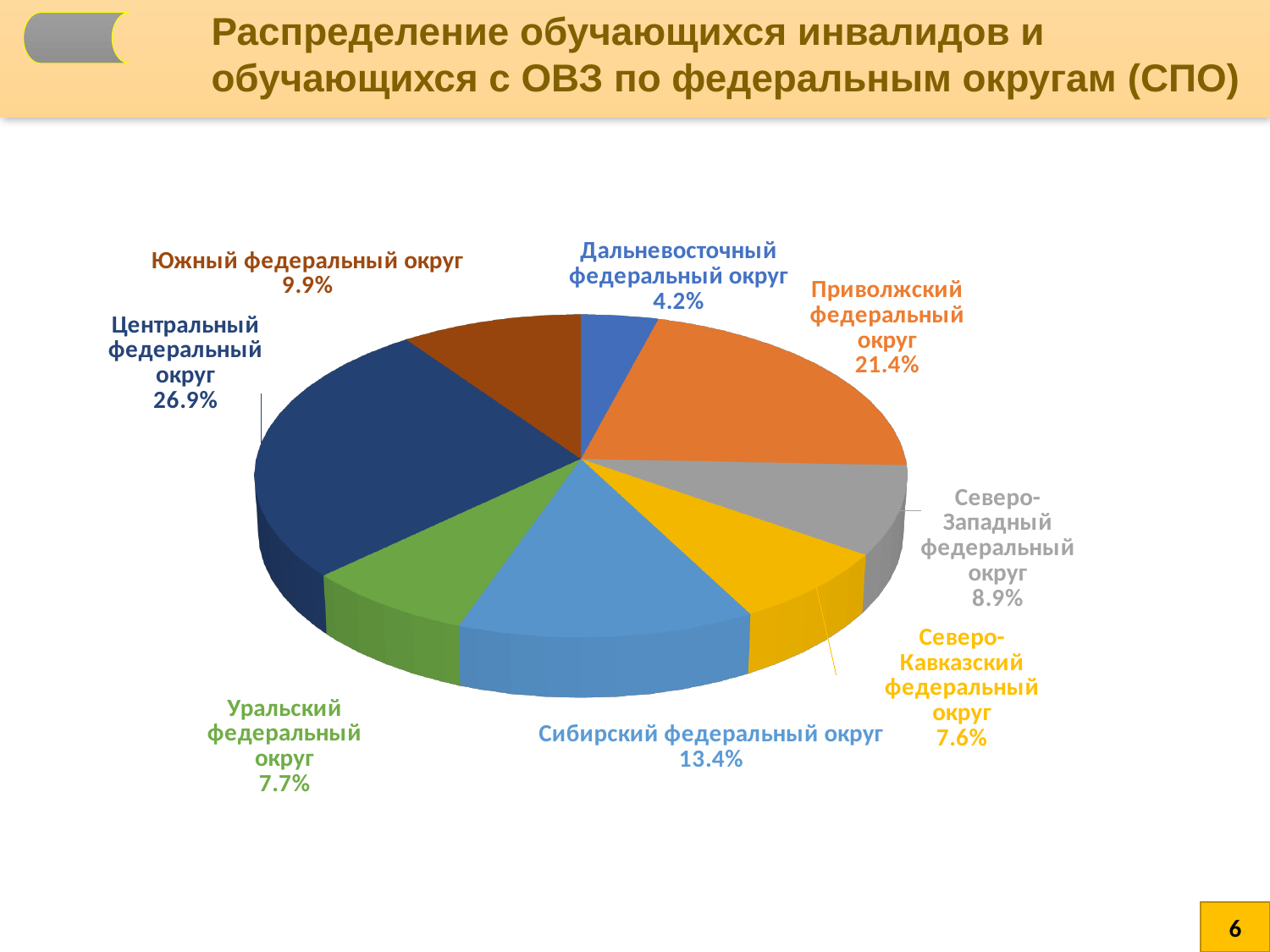
What share does Центральный федеральный округ have? 26.9% What kind of chart is shown on the slide? pie chart What is the difference between the shares of Уральский федеральный округ and Северо-Кавказский федеральный округ? 0.1% What share does Сибирский федеральный округ have? 13.4% What colour is the slice for Сибирский федеральный округ? light blue Which has a larger share, Южный федеральный округ or Северо-Западный федеральный округ? Южный федеральный округ What share does Приволжский федеральный округ have? 21.4% What is the difference between the shares of Центральный федеральный округ and Приволжский федеральный округ? 5.5% What share does Дальневосточный федеральный округ have? 4.2% Which federal district has the smallest share? Дальневосточный федеральный округ Which federal district has the largest share? Центральный федеральный округ How many federal districts are shown in the pie chart? 8